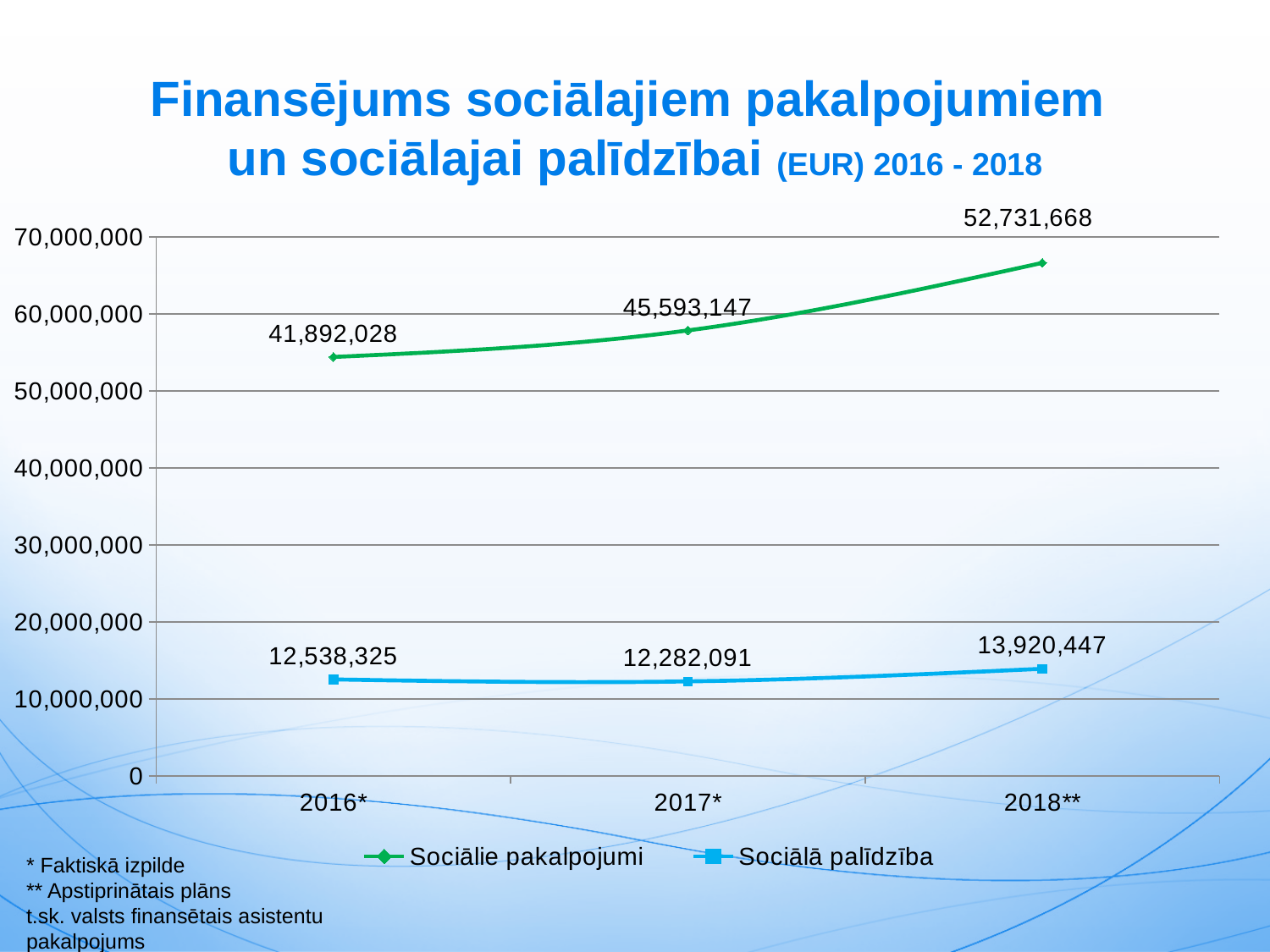
What is the value for Sociālie pakalpojumi in 2018**? 52,731,668 Which series is shown in green? Sociālie pakalpojumi What is the value for Sociālā palīdzība in 2017*? 12,282,091 How many years are plotted on the x axis? 3 By how much did Sociālie pakalpojumi increase from 2016* to 2018**? 10,839,640 In which year is Sociālie pakalpojumi highest? 2018** What is the value for Sociālie pakalpojumi in 2016*? 41,892,028 What kind of chart is shown on the slide? Line chart In which year is Sociālā palīdzība lowest? 2017* What is the difference between Sociālie pakalpojumi and Sociālā palīdzība in 2017*? 33,311,056 How many series does the legend list? 2 Does the value for Sociālie pakalpojumi rise or fall from 2016* to 2018**? Rise